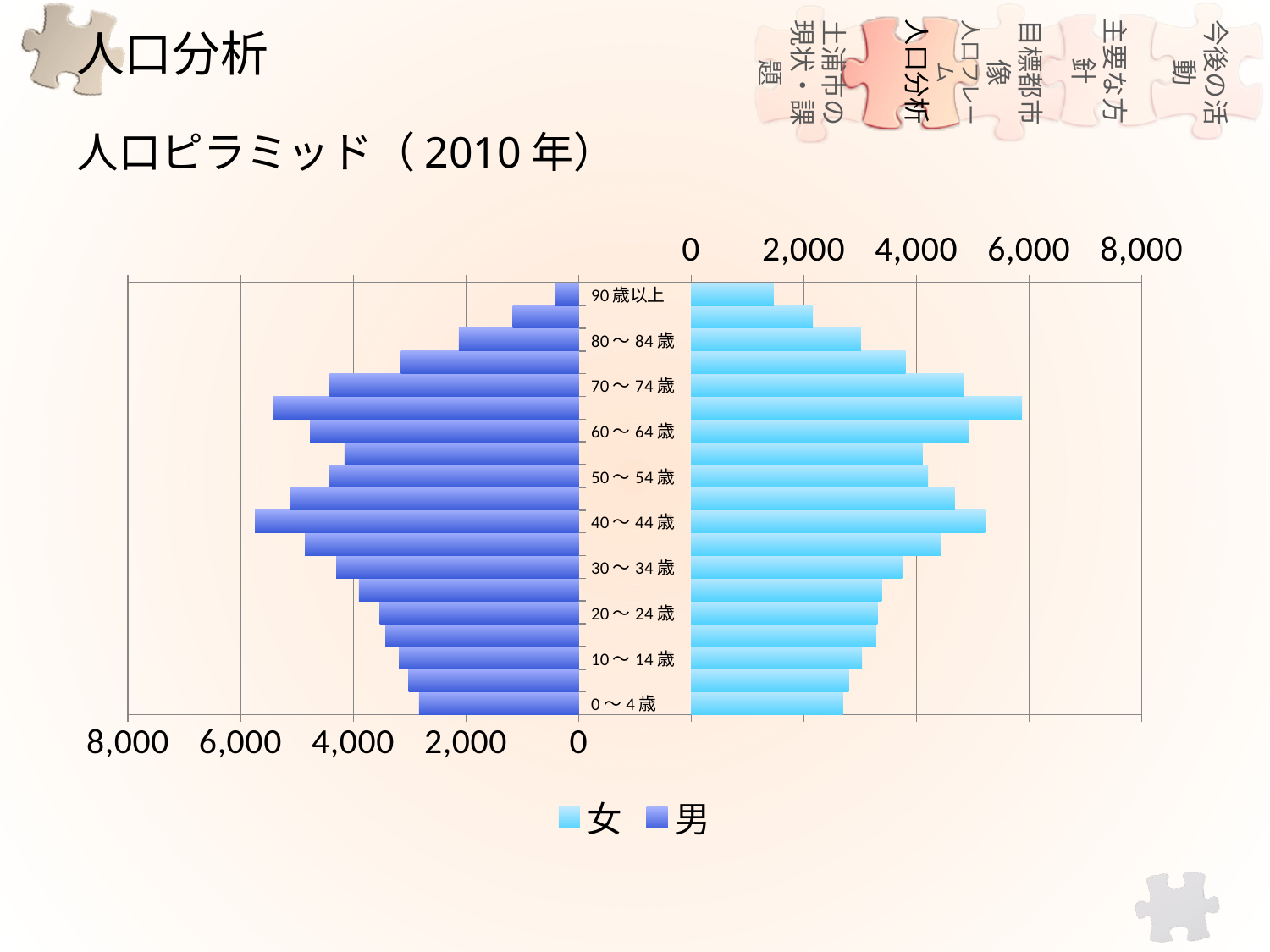
For the 女 series, which is larger: the value for 70～74歳 or the value for 20～24歳? 70～74歳 How many age-group bars are plotted for the 男 series? 19 Is the 男 value for 40～44歳 greater or less than 4,000? greater Which age group has the lowest value for the 女 series? 90歳以上 Is the 女 value for 40～44歳 greater or less than 6,000? less How many series does the legend list? 2 Is the 女 value for 70～74歳 greater or less than 4,000? greater What is the title of the chart? 人口ピラミッド（2010年） What are the two series named in the legend? 女 and 男 What kind of chart is shown on the slide? bar chart Which age group has the lowest value for the 男 series? 90歳以上